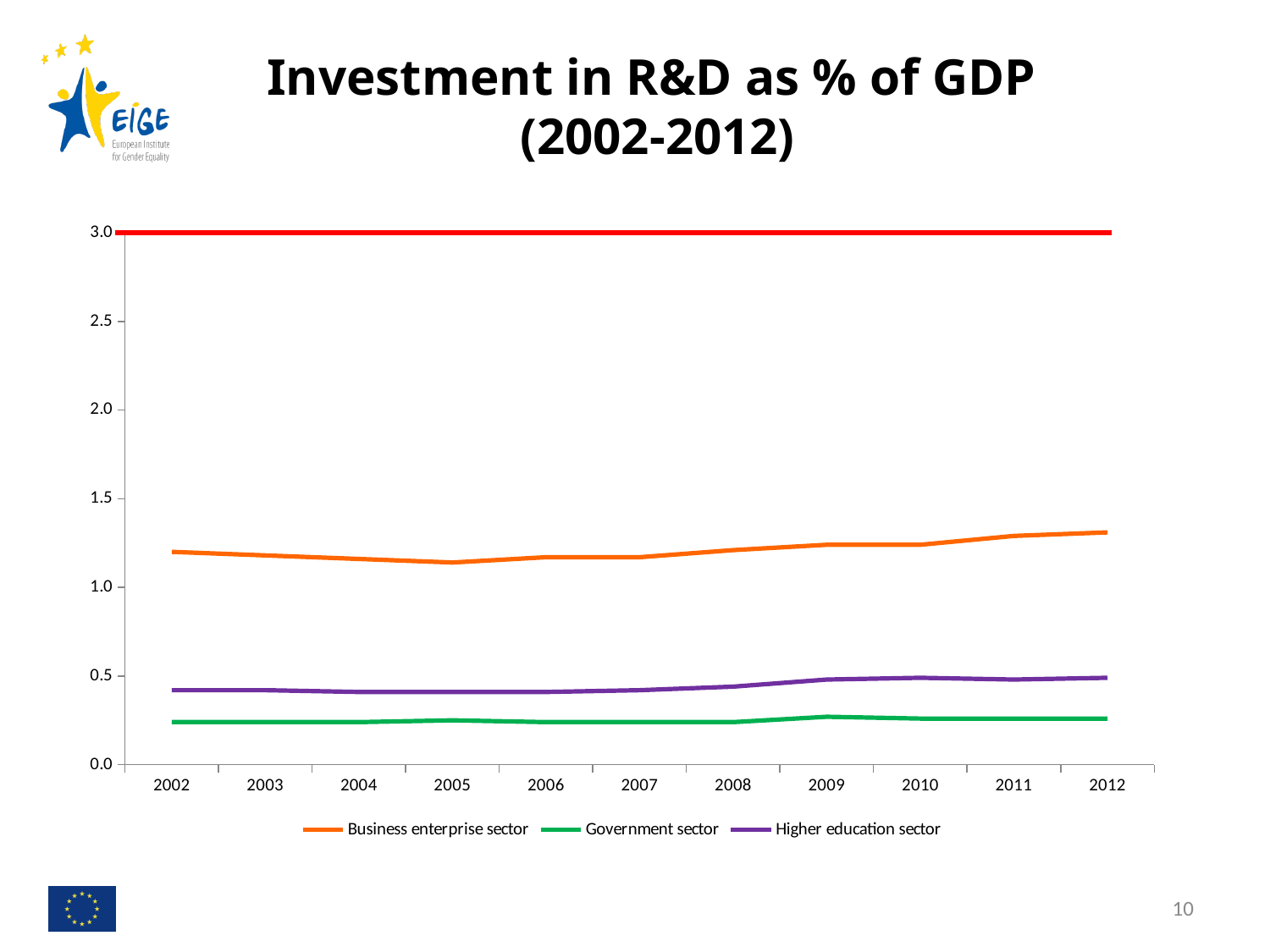
Which is larger in 2012, the value for the Higher education sector or the Government sector? Higher education sector Is the value for the Business enterprise sector in 2012 greater or less than 1.5? less How many series does the legend list? 3 Which sector has the highest investment in R&D as % of GDP in 2012? Business enterprise sector Which sector has the lowest investment in R&D as % of GDP in 2005? Government sector Which is larger in 2008, the value for the Business enterprise sector or the Higher education sector? Business enterprise sector What is the title of the chart? Investment in R&D as % of GDP (2002-2012) Does the Business enterprise sector line rise or fall between 2005 and 2012? rise Is the value for the Business enterprise sector in 2005 greater or less than 1.0? greater What kind of chart is shown on the slide? line chart Is the value for the Higher education sector in 2002 greater or less than 0.5? less How many years are shown along the x axis? 11